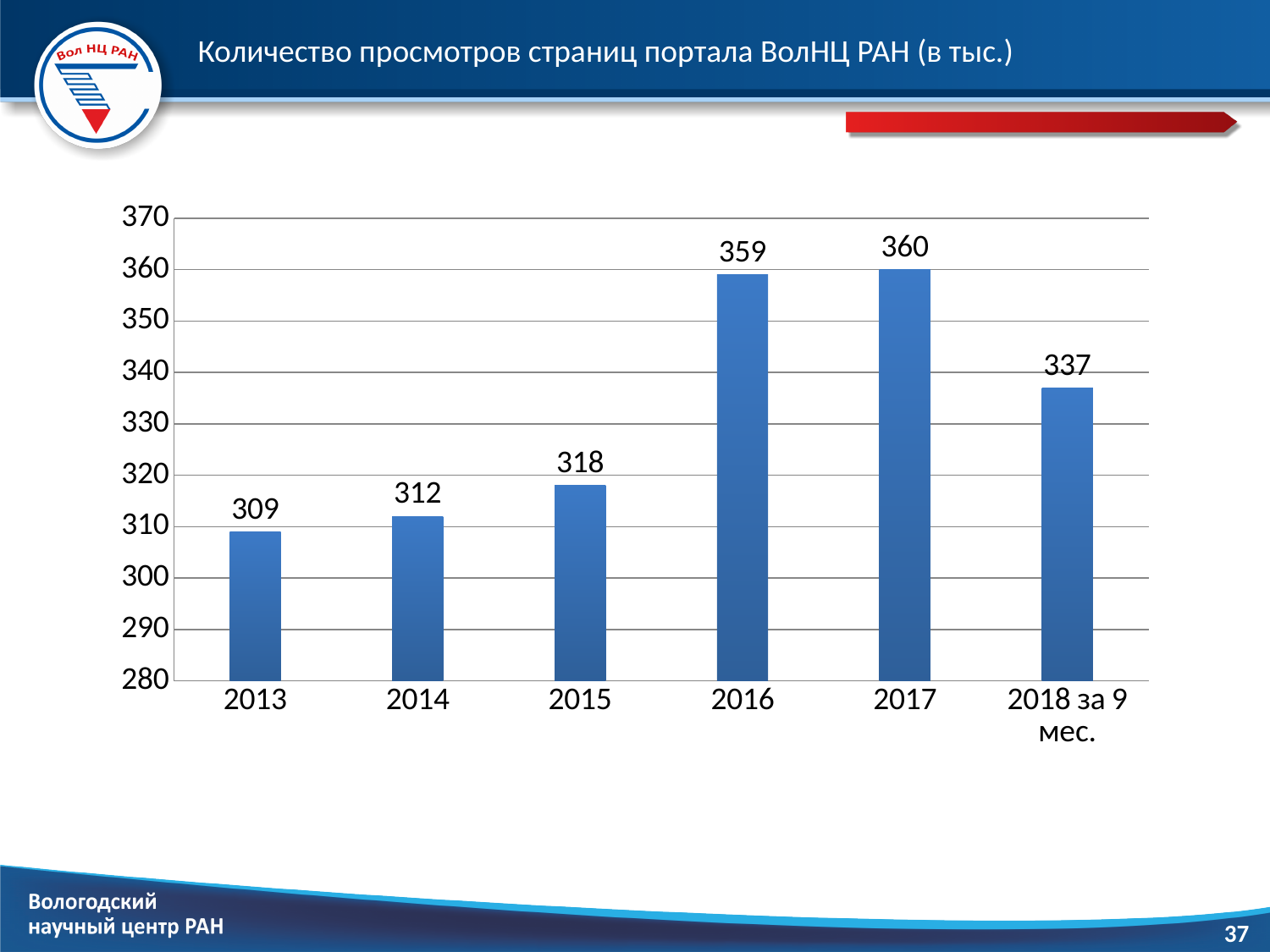
What is the title of the slide's chart? Количество просмотров страниц портала ВолНЦ РАН (в тыс.) What is the difference between the values for 2017 and 2013? 51 Which category has the highest value? 2017 Is the value for 2014 greater or less than 320? less What is the value for 2016? 359 Which category has the lowest value? 2013 Which is larger, the value for 2015 or the value for 2018 за 9 мес.? 2018 за 9 мес. How many categories are shown on the x axis? 6 What is the value for 2018 за 9 мес.? 337 What kind of chart is shown on the slide? bar chart What is the difference between the values for 2016 and 2015? 41 What is the value for 2013? 309